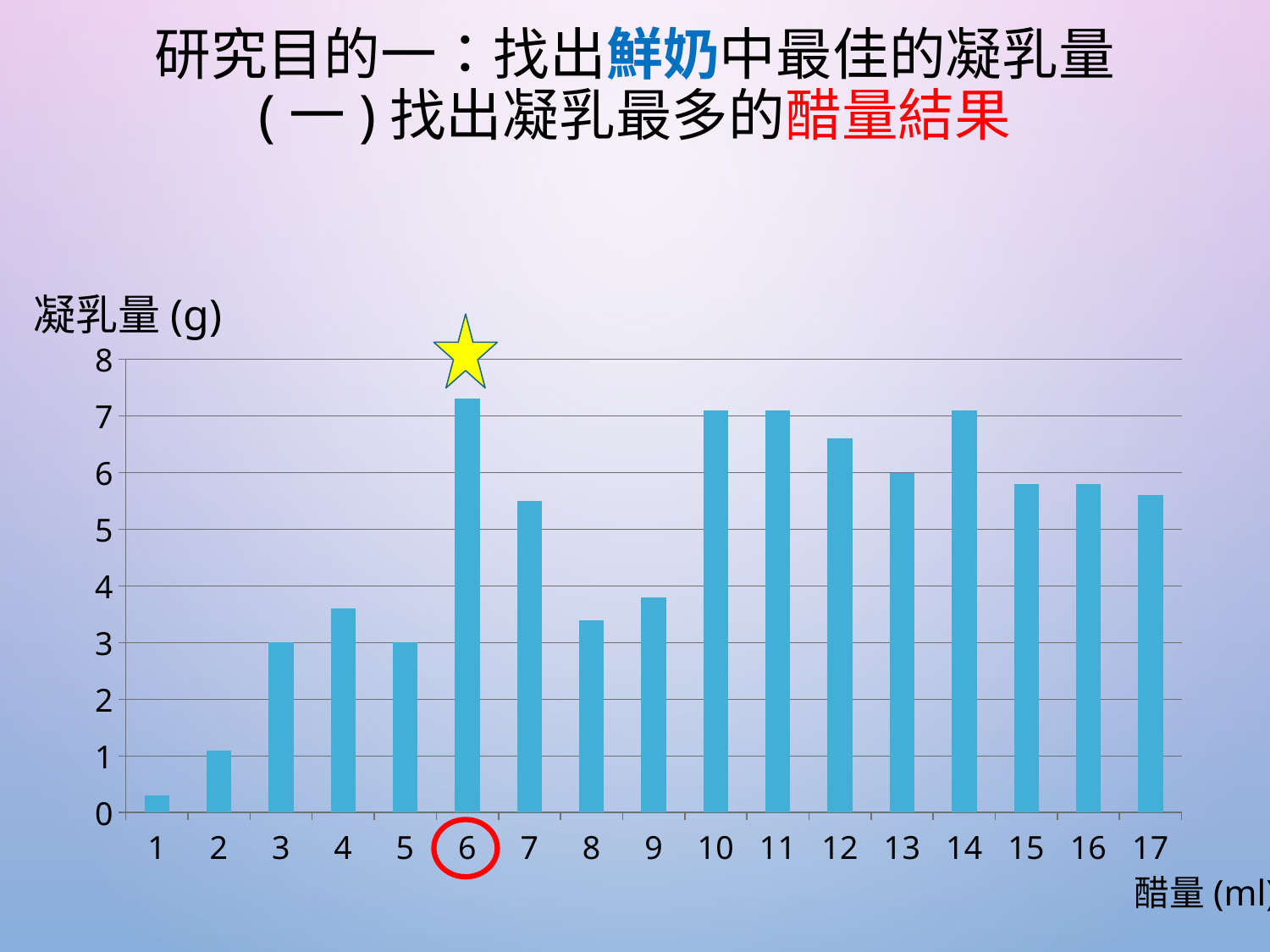
What kind of chart is shown on the slide? bar chart What is the label of the vertical axis? 凝乳量 (g) Which x-axis category is circled in red and marked with a star? 6 Which has a larger 凝乳量 (g): 醋量 6 ml or 醋量 8 ml? 6 ml Do the 凝乳量 (g) values rise or fall from 醋量 1 ml to 4 ml? rise Is the 凝乳量 (g) for 醋量 4 ml greater or less than 4? less Is the 凝乳量 (g) for 醋量 2 ml greater or less than 2? less Is the 凝乳量 (g) for 醋量 12 ml greater or less than 6? greater Which 醋量 (ml) value has the highest 凝乳量 (g)? 6 How many 醋量 (ml) categories are plotted on the x axis? 17 Which 醋量 (ml) value has the lowest 凝乳量 (g)? 1